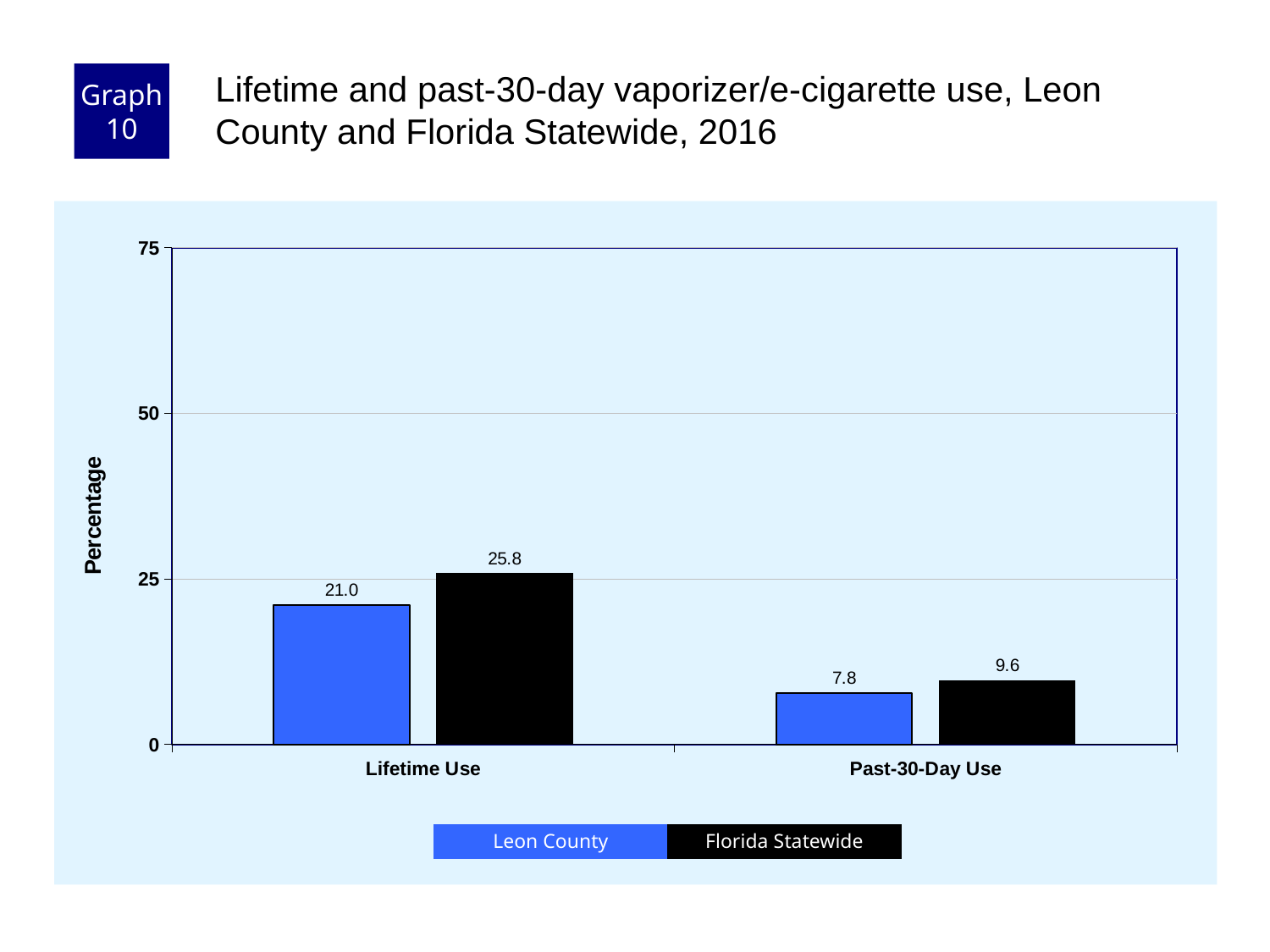
Is the Florida Statewide value for Lifetime Use greater or less than 25? greater What is the Leon County value for Past-30-Day Use? 7.8 What is the Florida Statewide value for Lifetime Use? 25.8 How many series does the legend list? 2 For Past-30-Day Use, which is larger: Leon County or Florida Statewide? Florida Statewide Which bar has the lowest value on the chart? Leon County, Past-30-Day Use What is the Florida Statewide value for Past-30-Day Use? 9.6 What is the difference between the Florida Statewide and Leon County values for Past-30-Day Use? 1.8 What is the difference between the Florida Statewide and Leon County values for Lifetime Use? 4.8 What is the Leon County value for Lifetime Use? 21.0 What type of chart is shown on the slide? Bar chart Which bar has the highest value on the chart? Florida Statewide, Lifetime Use